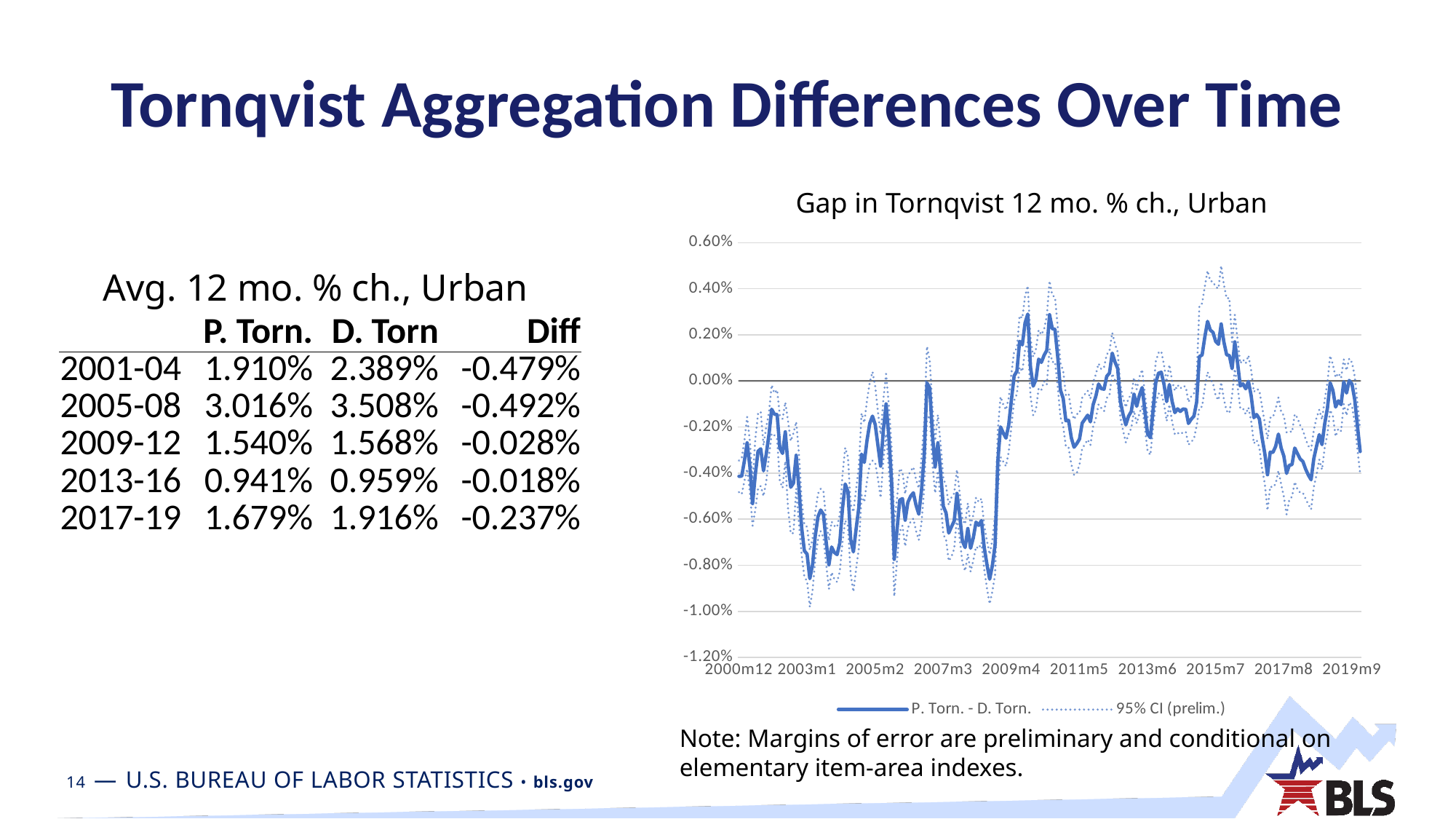
Is the value of the solid line at 2013m6 greater or less than -0.40%? greater Does the solid P. Torn. - D. Torn. line rise or fall overall between 2009m4 and 2011m5? fall Does the solid P. Torn. - D. Torn. line rise or fall overall between 2015m7 and 2017m8? fall How many x-axis labels are shown on the chart? 10 Is the value of the solid line at 2003m1 greater or less than -0.60%? less What are the two series named in the chart legend? P. Torn. - D. Torn. and 95% CI (prelim.) What kind of chart is shown on the slide? line chart Is the highest point of the solid P. Torn. - D. Torn. line greater or less than 0.20%? greater Which is larger, the solid line's value at 2003m1 or at 2013m6? 2013m6 What is the title of the chart on the right of the slide? Gap in Tornqvist 12 mo. % ch., Urban How many series does the chart legend list? 2